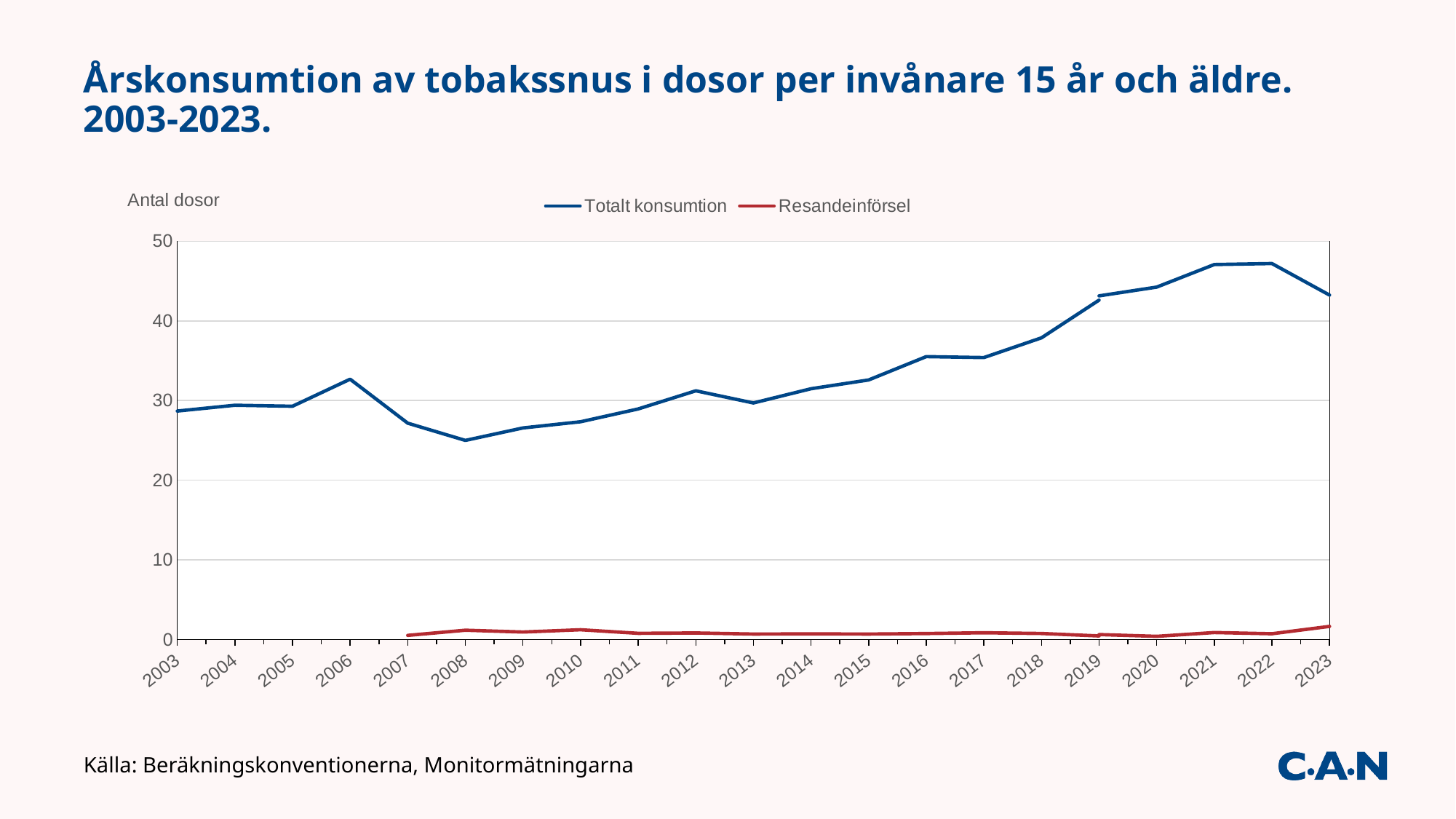
Is the value for Totalt konsumtion in 2016 greater or less than 30? greater What are the two series named in the legend? Totalt konsumtion and Resandeinförsel Does Totalt konsumtion rise or fall from 2006 to 2008? Fall Is the value for Totalt konsumtion in 2023 greater or less than 40? greater Is the value for Totalt konsumtion in 2008 greater or less than 30? less Which year has the lowest value for Totalt konsumtion? 2008 How many series does the legend list? 2 How many years are shown on the x axis? 21 Does Totalt konsumtion rise or fall from 2013 to 2021? Rise What kind of chart is shown on the slide? Line chart Which is larger, Totalt konsumtion in 2019 or in 2013? 2019